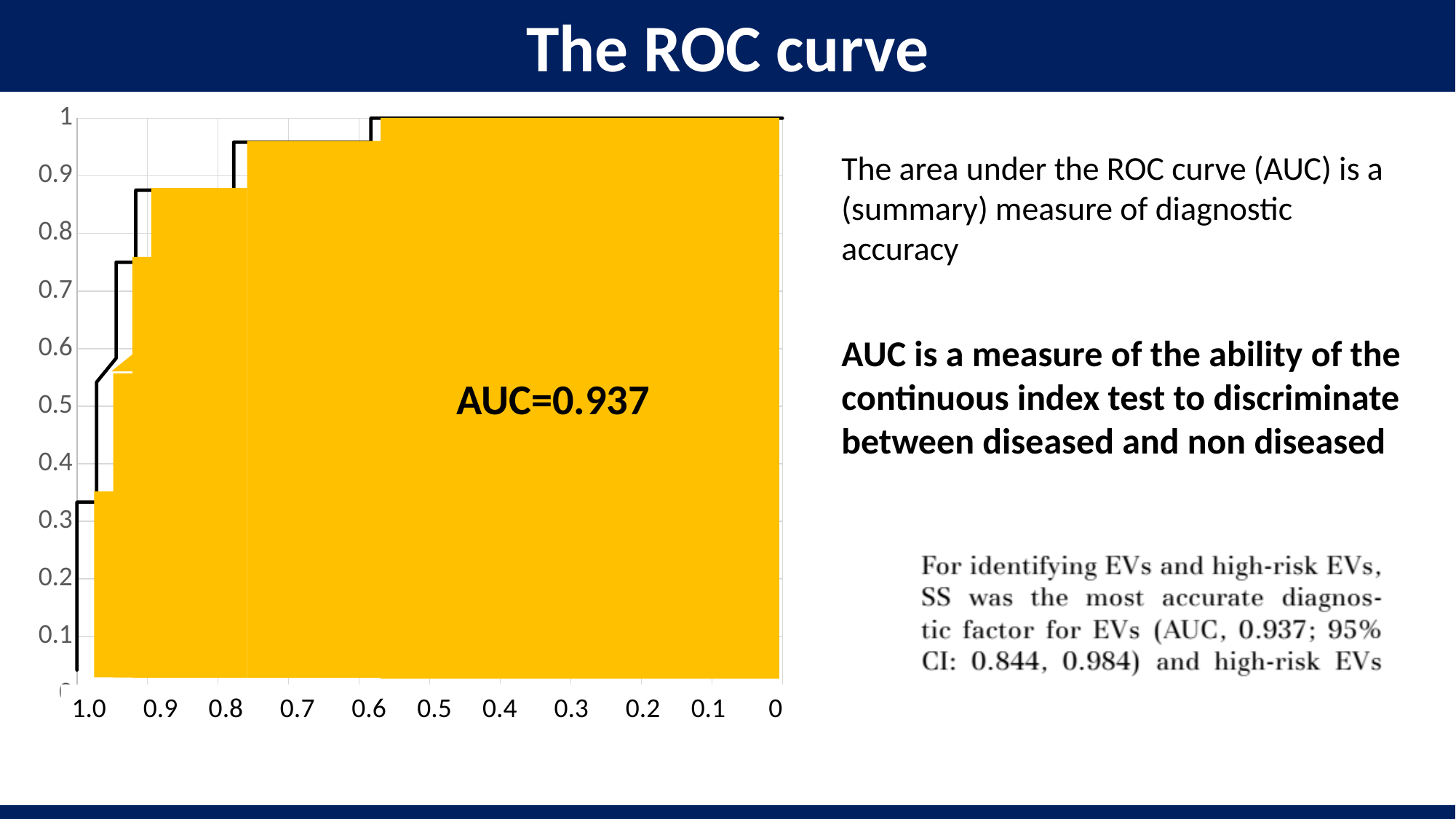
Does the ROC curve rise or fall as you move from left to right along the x axis? Rise Is the AUC value printed on the chart greater or less than 0.9? greater What is the title of the slide containing the chart? The ROC curve What kind of chart is shown on the slide? ROC curve (line chart with shaded area) What colour is the shaded area under the ROC curve? Yellow/orange At x = 0.9 on the ROC curve chart, is the curve value greater or less than 0.8? greater How many tick labels are shown on the x axis of the ROC curve chart? 11 What AUC value is printed on the ROC curve chart? AUC=0.937 What is the rightmost value labelled on the x axis of the ROC curve chart? 0 At x = 0.5 on the ROC curve chart, is the curve value greater or less than 0.9? greater What is the highest value labelled on the y axis of the ROC curve chart? 1 What is the leftmost value labelled on the x axis of the ROC curve chart? 1.0